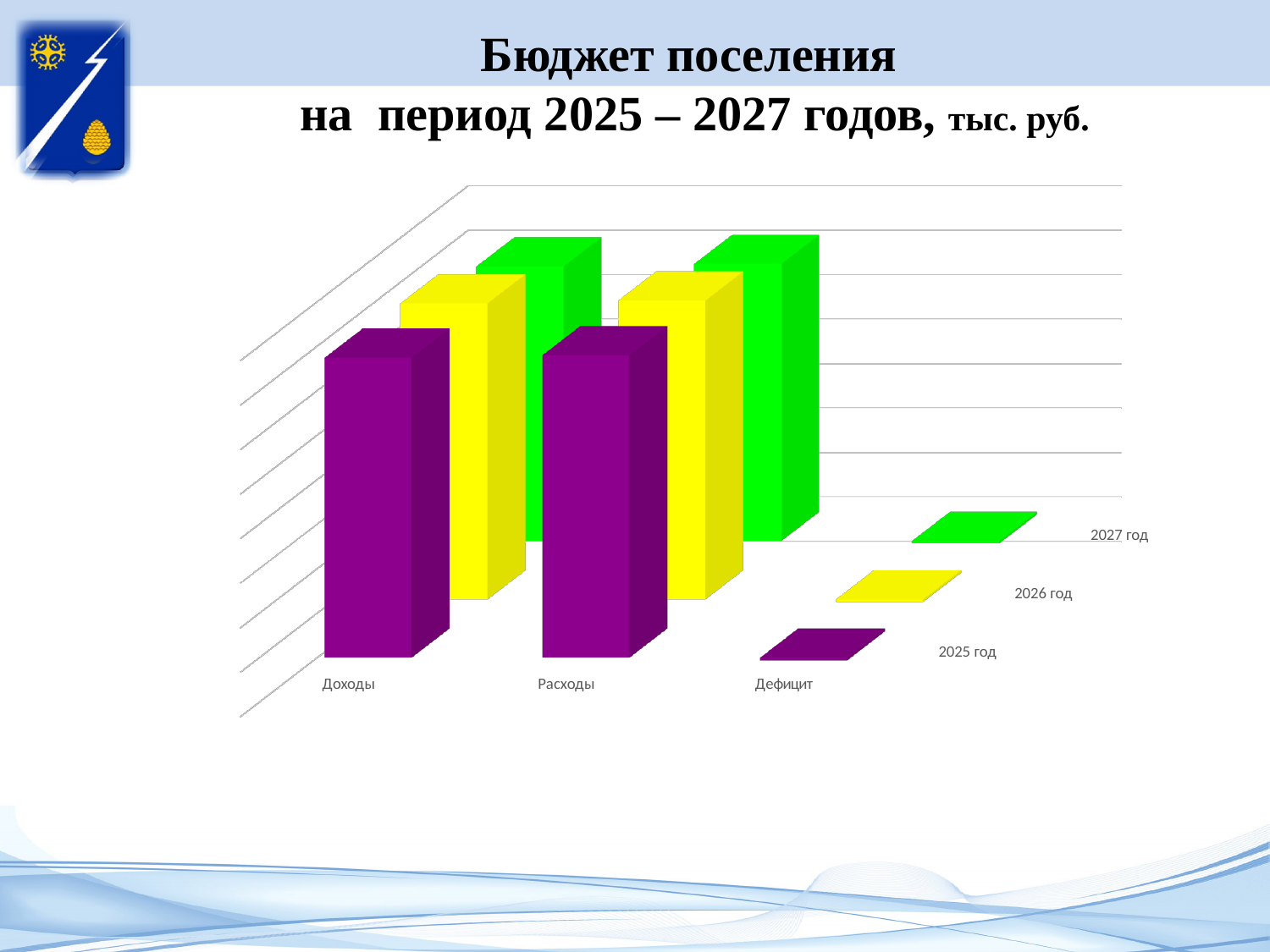
What colour represents the 2025 год series in the chart? purple How many categories are shown along the x axis of the chart? 3 What kind of chart is shown on the slide? bar chart Which category has the lowest values across all years in the chart? Дефицит For 2025 год, which is larger: Доходы or Дефицит? Доходы What is the title of the slide containing the chart? Бюджет поселения на период 2025 – 2027 годов, тыс. руб. For 2027 год, which is larger: Расходы or Дефицит? Расходы